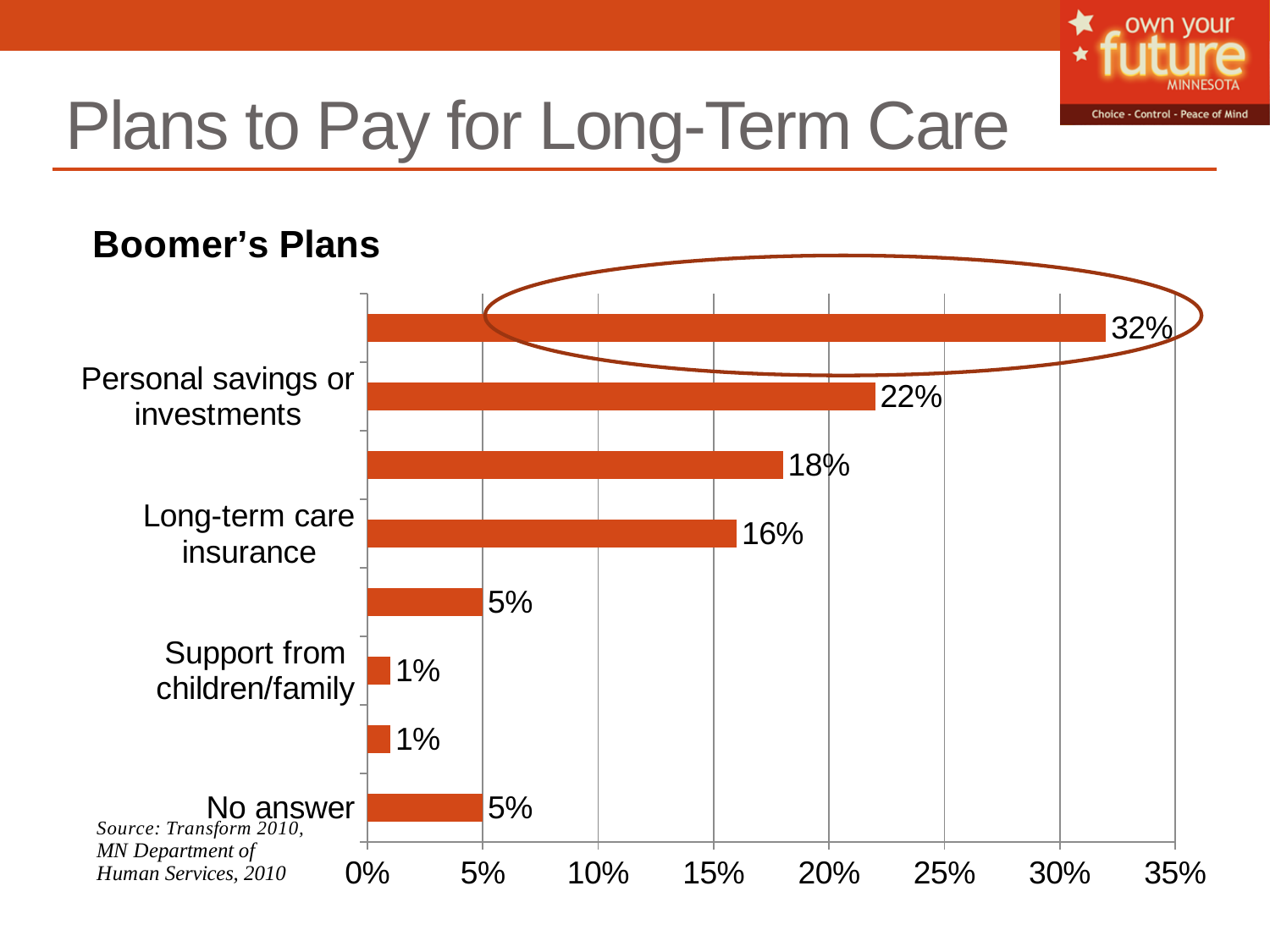
What value is labelled on the bar that is circled on the chart? 32% What kind of chart is shown on the slide? bar chart What is the smallest value shown on any bar in the chart? 1% What is the value for 'Long-term care insurance'? 16% What is the value of the longest bar in the chart? 32% What is the difference between the largest bar (32%) and the second largest bar (22%)? 10% Is the value of the longest bar greater or less than 30%? greater Which is larger, the value for 'Personal savings or investments' or the value for 'Long-term care insurance'? Personal savings or investments How many bars are plotted in the chart? 8 What is the value for 'Support from children/family'? 1% What is the value for 'No answer'? 5% What is the value for 'Personal savings or investments'? 22%